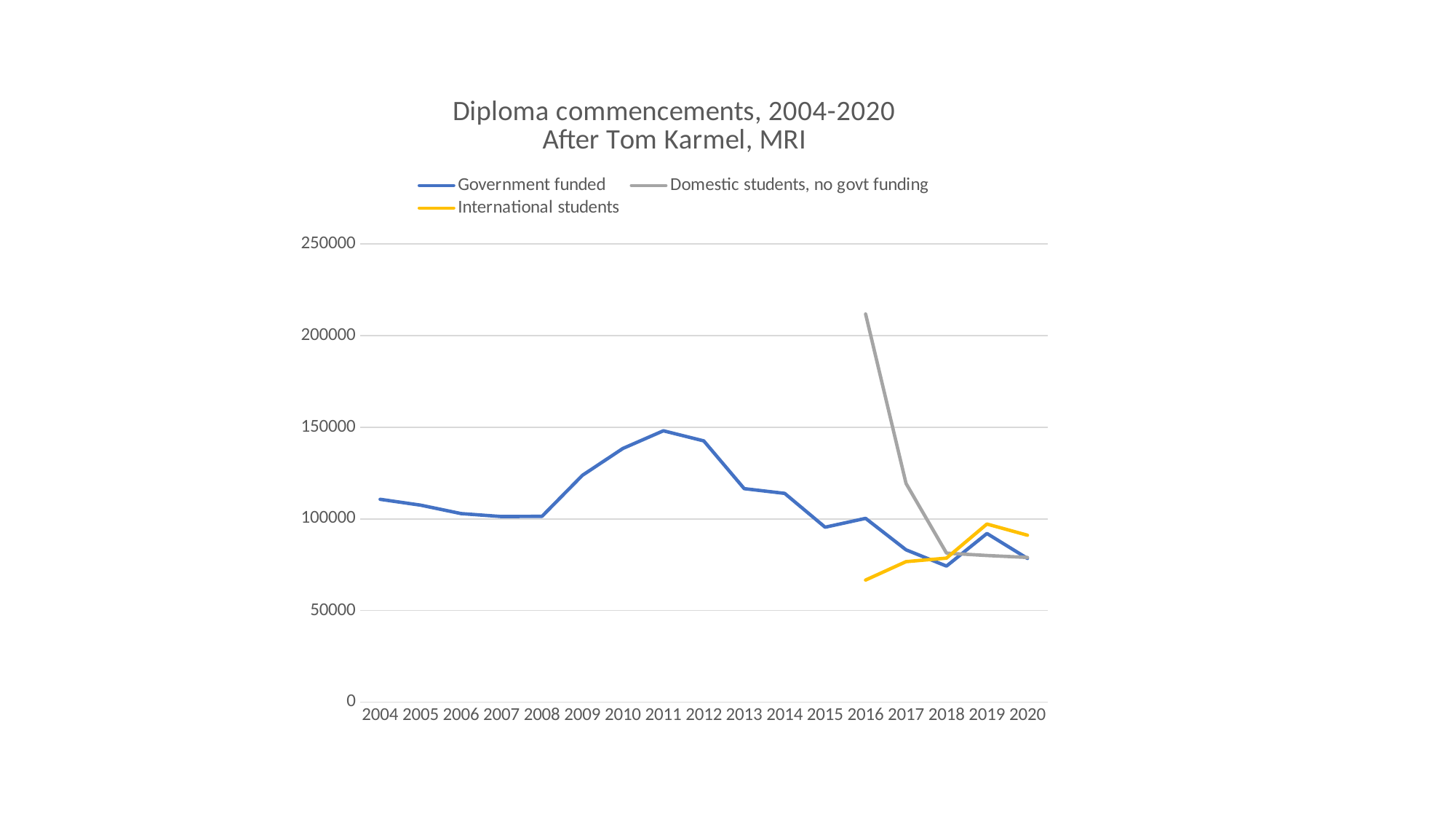
In which year does the Government funded series reach its lowest value? 2018 Does the Domestic students, no govt funding series rise or fall from 2016 to 2020? fall What is the title of the chart? Diploma commencements, 2004-2020 After Tom Karmel, MRI In 2020, which series has the larger value: International students or Domestic students, no govt funding? International students Is the value for Domestic students, no govt funding in 2016 greater or less than 200000? greater In which year does the Government funded series reach its highest value? 2011 Is the value for Government funded in 2018 greater or less than 100000? less How many years are shown along the x axis? 17 Is the value for International students in 2016 greater or less than 100000? less What kind of chart is shown on the slide? line chart In 2016, which series has the larger value: Government funded or Domestic students, no govt funding? Domestic students, no govt funding How many series does the legend list? 3